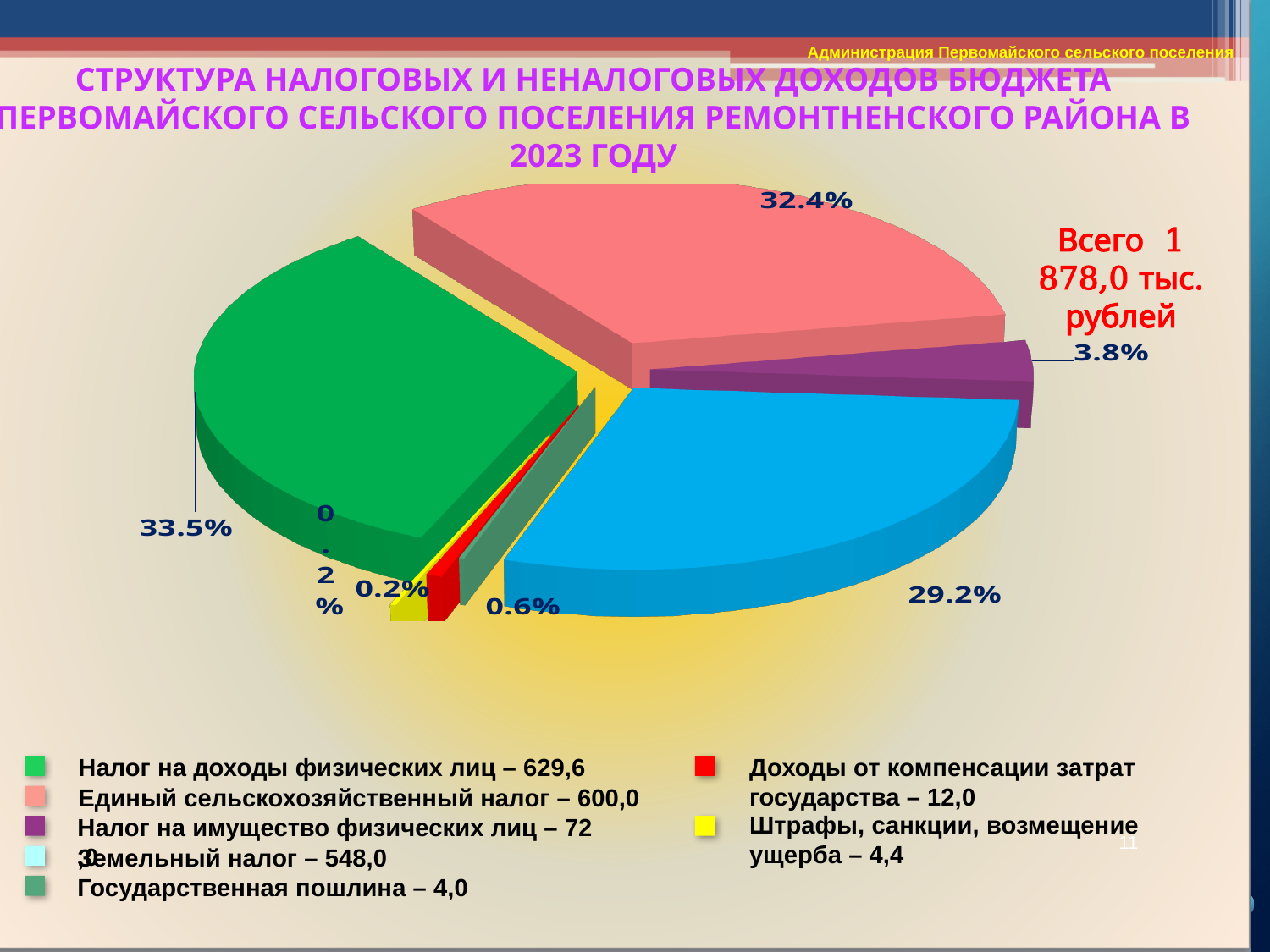
What kind of chart is shown on the slide? pie chart What share of the pie does Налог на доходы физических лиц take? 33.5% What value does the legend give for Земельный налог? 548,0 By how much does the value for Налог на доходы физических лиц exceed the value for Единый сельскохозяйственный налог? 29,6 What value does the legend give for Государственная пошлина? 4,0 How many categories does the legend list? 7 Which is larger, the slice for Единый сельскохозяйственный налог or the slice for Земельный налог? Единый сельскохозяйственный налог What share of the pie does Земельный налог take? 29.2% What value does the legend give for Доходы от компенсации затрат государства? 12,0 Which category has the largest slice of the pie? Налог на доходы физических лиц What share of the pie does Налог на имущество физических лиц take? 3.8%